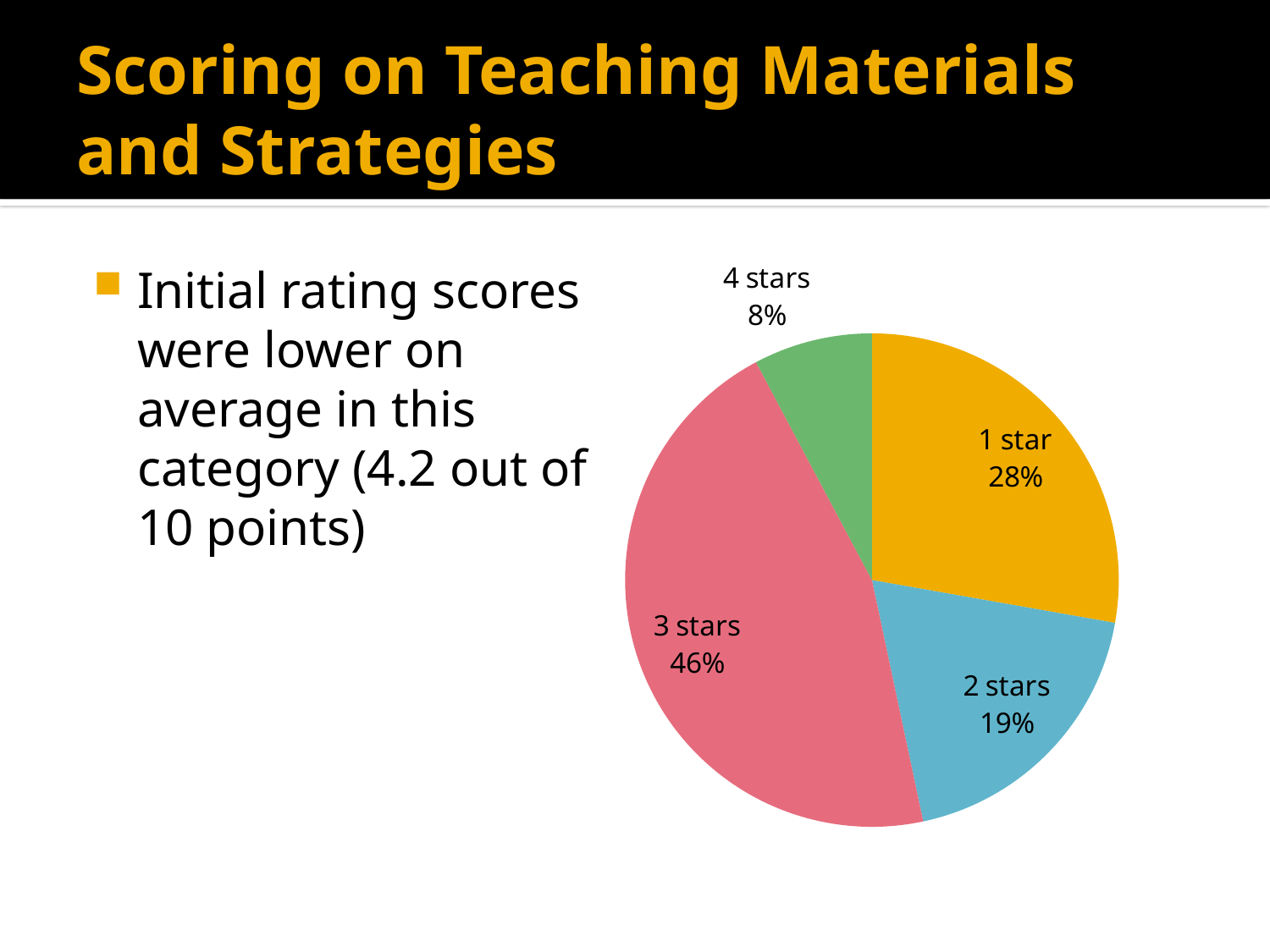
What colour is the 3 stars slice of the pie? red/pink What kind of chart is shown on the slide? pie chart What is the value shown for 1 star? 28% Which rating category has the smallest slice of the pie? 4 stars What is the value shown for 2 stars? 19% Which rating category has the largest slice of the pie? 3 stars What share of the pie does the 3 stars slice represent? 46% What is the difference in percentage points between the 3 stars slice and the 1 star slice? 18 Which is larger, the 1 star slice or the 2 stars slice? 1 star How many slices does the pie chart have? 4 What is the value shown for 4 stars? 8% What is the difference in percentage points between the 2 stars slice and the 4 stars slice? 11